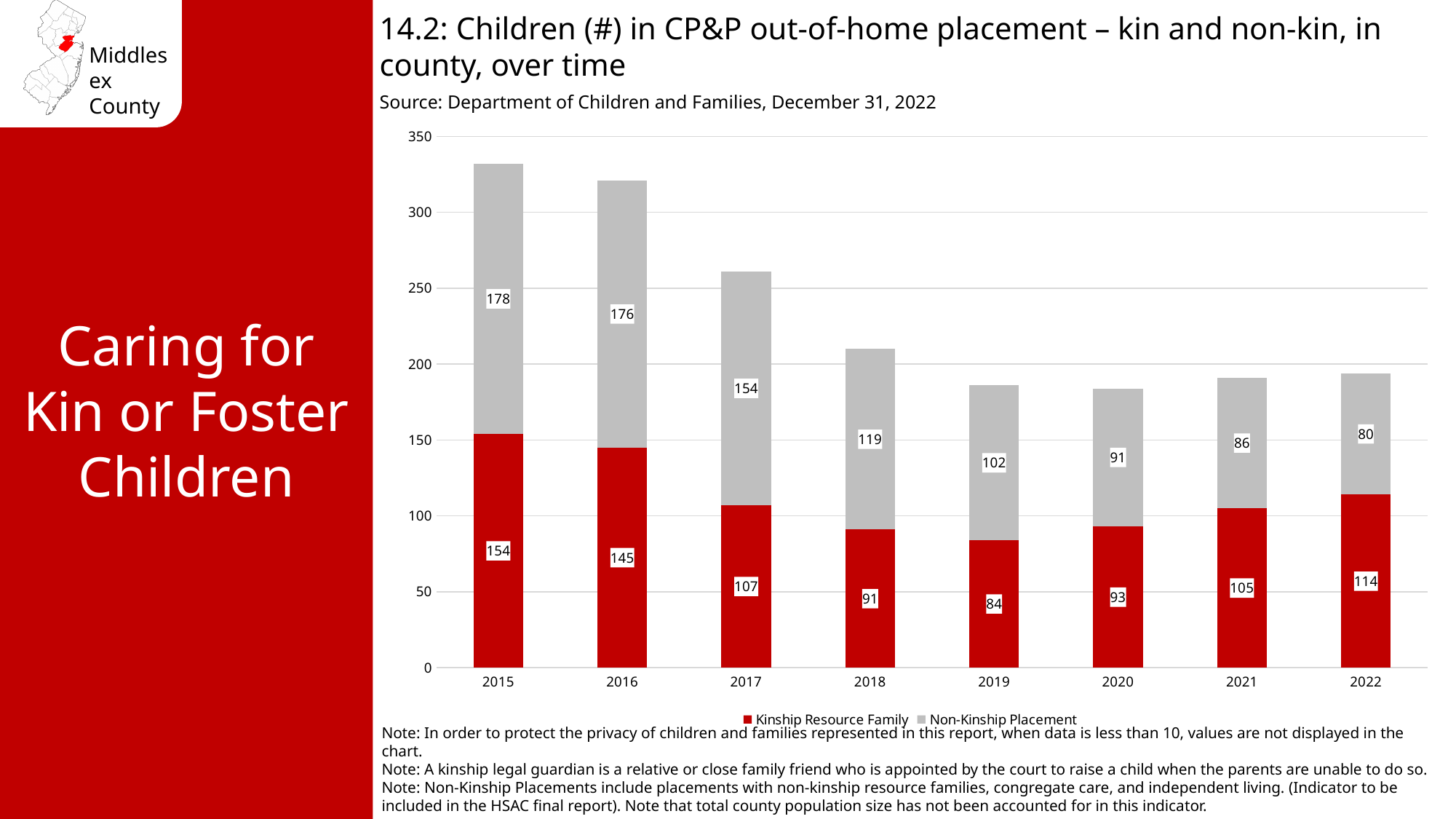
How many series does the legend list? 2 Which year has the lowest Kinship Resource Family value? 2019 Which colour represents Kinship Resource Family in the chart? Red How many years are shown on the x axis? 8 Does the Non-Kinship Placement value rise or fall from 2015 to 2022? Fall Which is larger in 2021: the Kinship Resource Family value or the Non-Kinship Placement value? Kinship Resource Family What is the total number of children in out-of-home placement in 2018 (both series combined)? 210 What is the Non-Kinship Placement value for 2017? 154 What type of chart is shown on the slide? Stacked bar chart What is the Kinship Resource Family value for 2019? 84 Which year has the highest Non-Kinship Placement value? 2015 What is the difference between the Non-Kinship Placement values for 2015 and 2022? 98